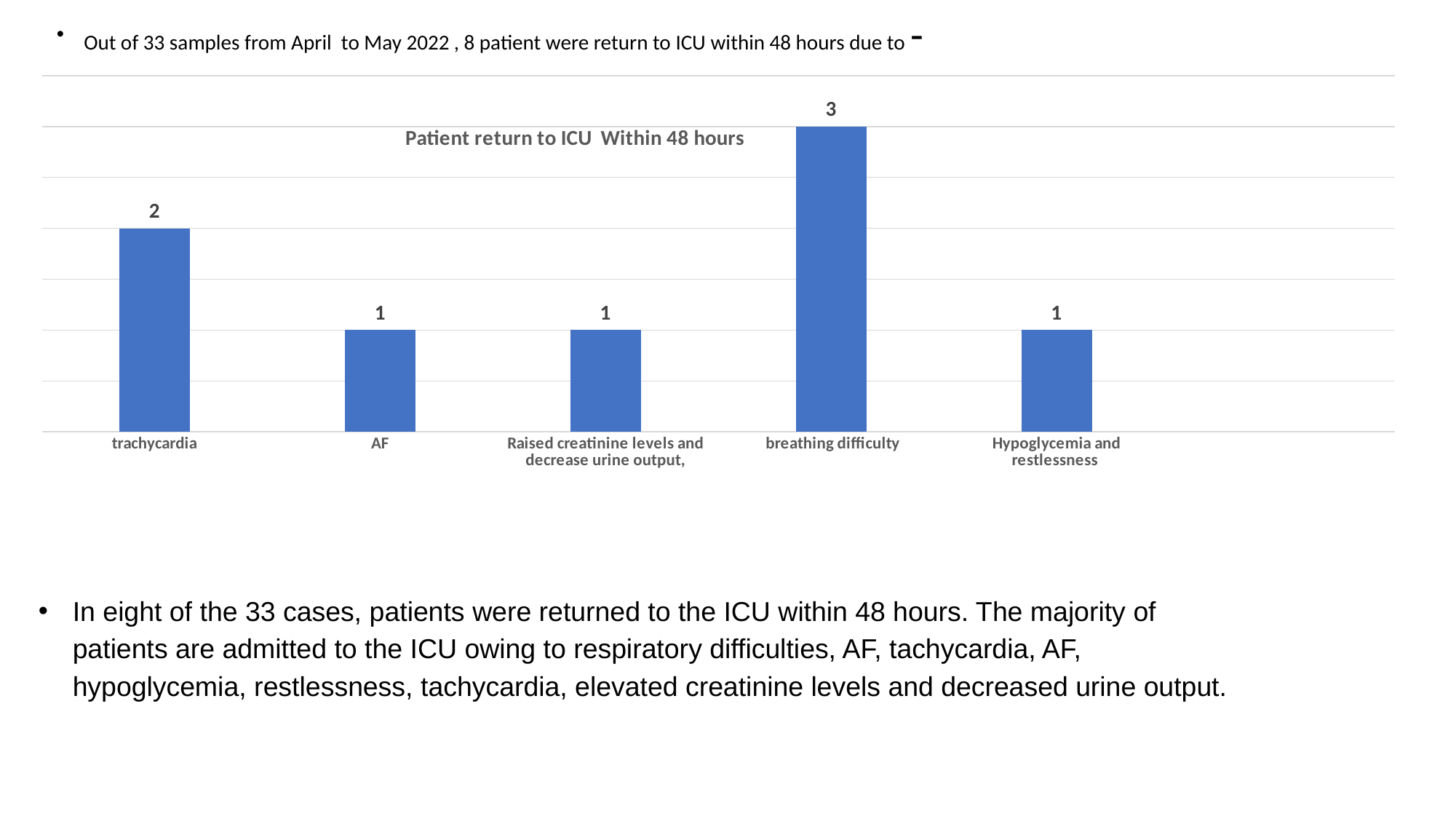
What is the difference between the values for breathing difficulty and trachycardia? 1 What is the total of all the values shown in the chart? 8 What is the value for Hypoglycemia and restlessness? 1 What kind of chart is shown on the slide? bar chart Which is larger, the value for trachycardia or the value for AF? trachycardia What is the value for trachycardia? 2 How many categories are shown in the chart? 5 Which category has the highest value? breathing difficulty What is the value for AF? 1 What colour are the bars in the chart? blue What is the value for breathing difficulty? 3 What is the title of the chart? Patient return to ICU Within 48 hours